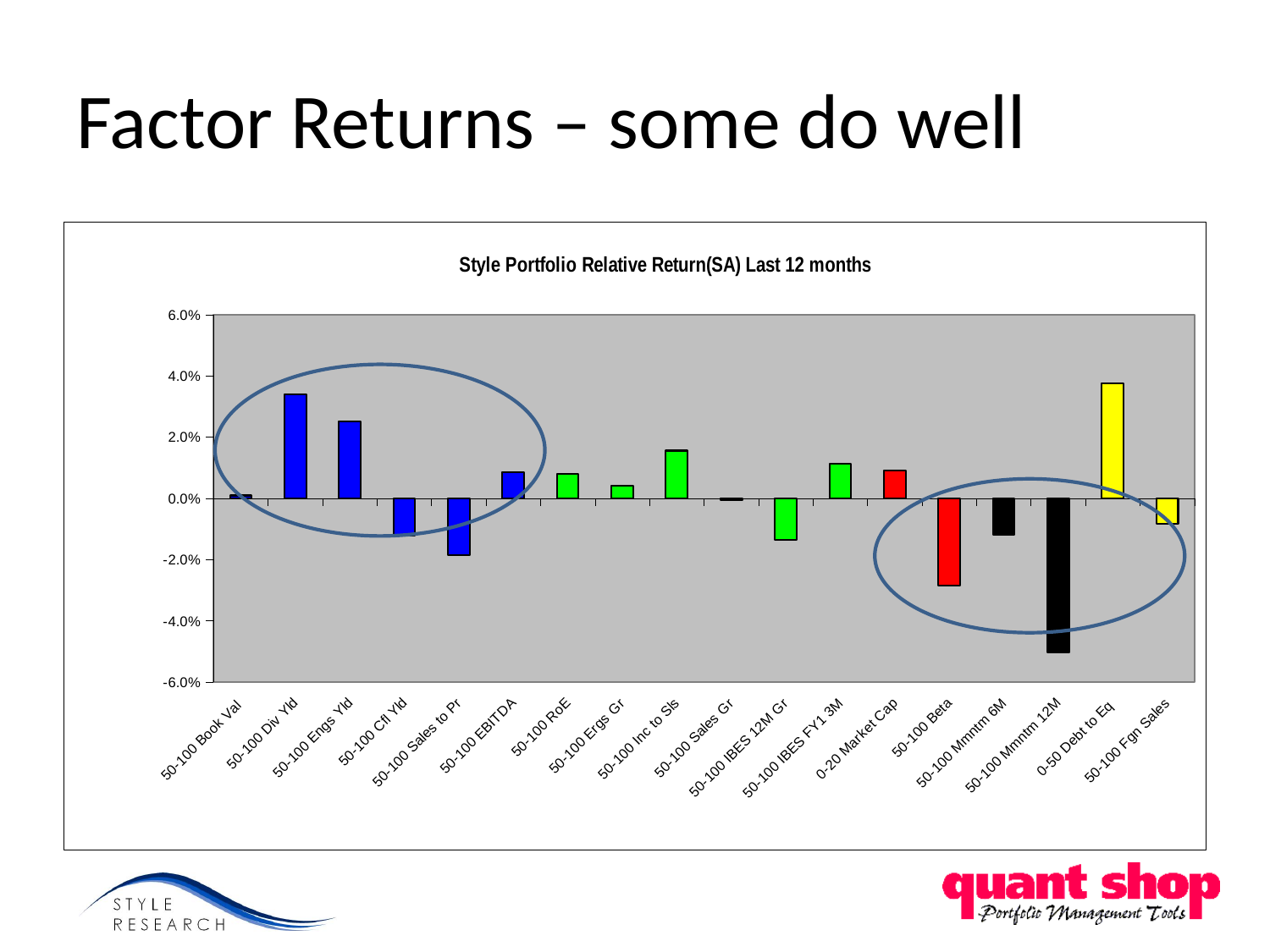
Which has the lower relative return, 50-100 Beta or 50-100 Mmntm 6M? 50-100 Beta Which category has the lowest relative return? 50-100 Mmntm 12M Is the value for 50-100 Beta greater or less than -2.0%? less Which category has the highest relative return? 0-50 Debt to Eq Is the value for 50-100 Mmntm 12M greater or less than -4.0%? less What is the title of the chart? Style Portfolio Relative Return(SA) Last 12 months What kind of chart is shown on the slide? Bar chart Is the value for 50-100 Div Yld greater or less than 2.0%? greater How many categories (factors) are plotted on the x axis? 18